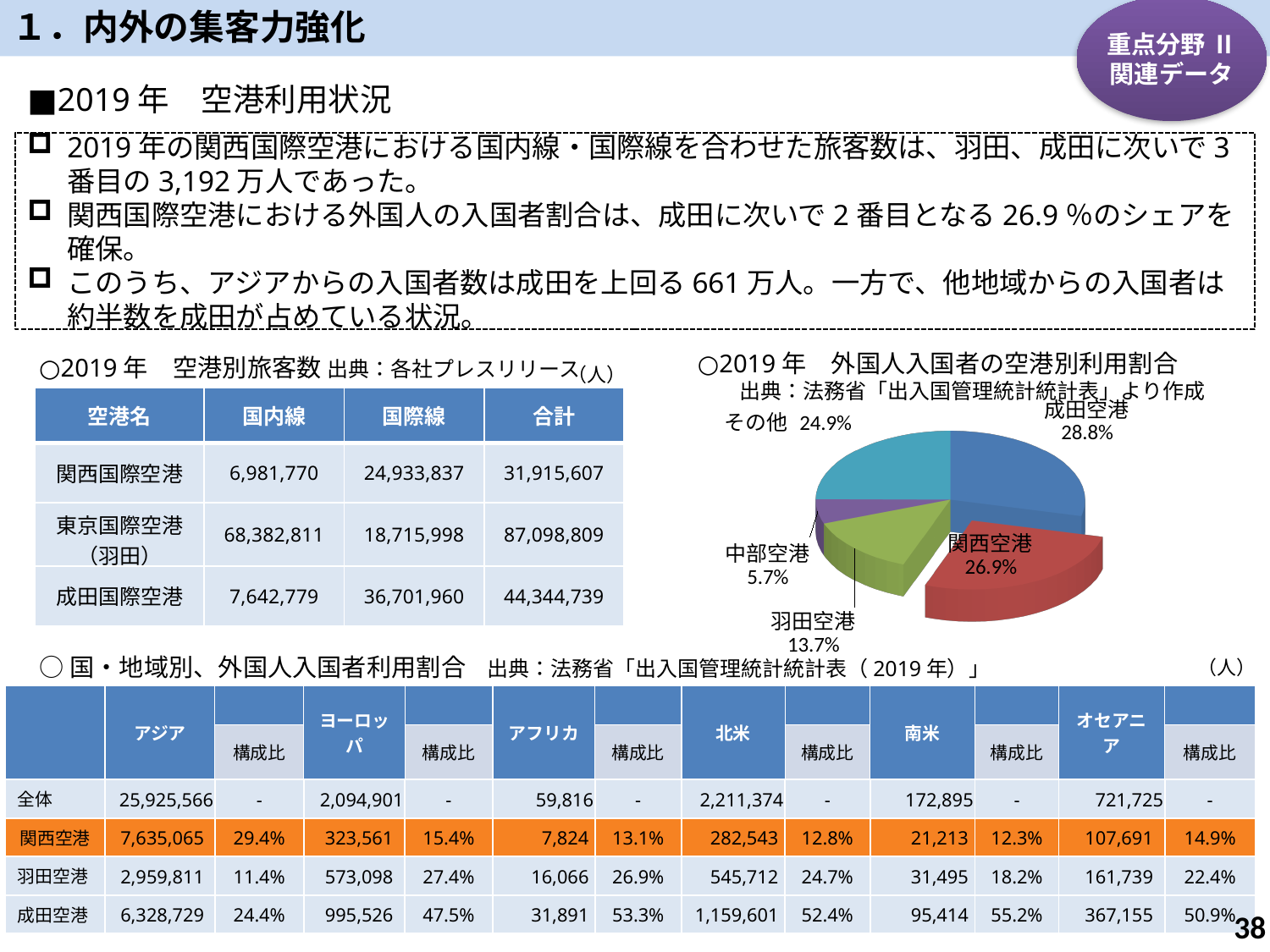
What is the title of the pie chart? 2019年 外国人入国者の空港別利用割合 In the pie chart, what share does 成田空港 have? 28.8% In the pie chart, what share does その他 have? 24.9% How many slices does the pie chart have? 5 In the pie chart, what share does 関西空港 have? 26.9% In the pie chart, which is larger: the share of 羽田空港 or the share of 中部空港? 羽田空港 Which slice of the pie chart is the smallest? 中部空港 Which slice of the pie chart is the largest? 成田空港 In the pie chart, what share does 中部空港 have? 5.7% In the pie chart, what share does 羽田空港 have? 13.7% In the pie chart, what is the difference between the shares of 成田空港 and 関西空港? 1.9% What kind of chart is shown on the slide? pie chart